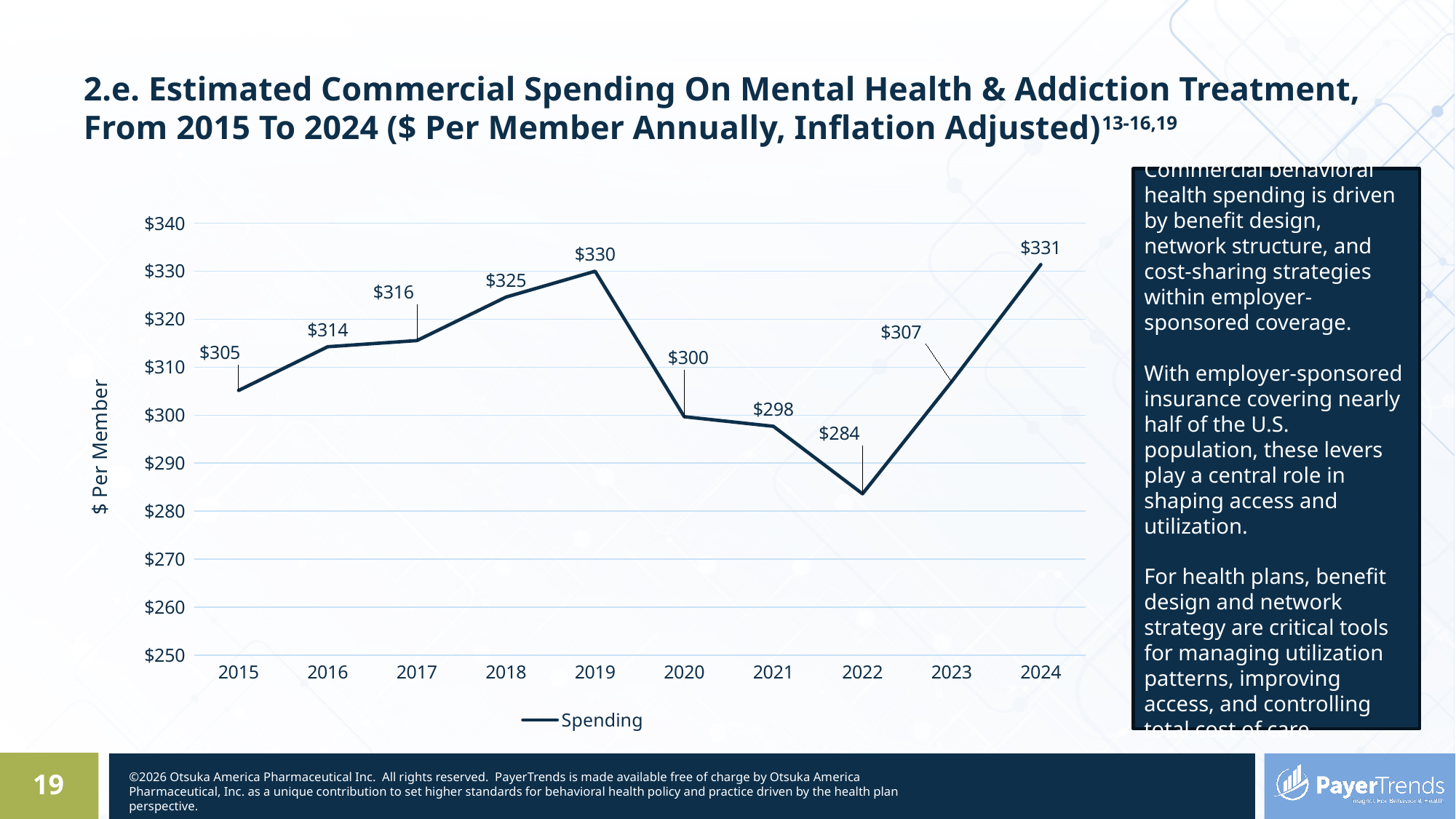
What type of chart is shown on the slide? line chart Which year has the highest spending per member? 2024 Which year has higher spending per member, 2018 or 2023? 2018 How many years are plotted on the chart? 10 Is the spending per member in 2021 greater or less than $300? less What series name is shown in the chart legend? Spending What is the spending per member in 2019? $330 What is the spending per member in 2022? $284 What is the difference in spending per member between 2024 and 2022? $47 Which year has the lowest spending per member? 2022 What is the spending per member in 2015? $305 What is the difference in spending per member between 2019 and 2020? $30